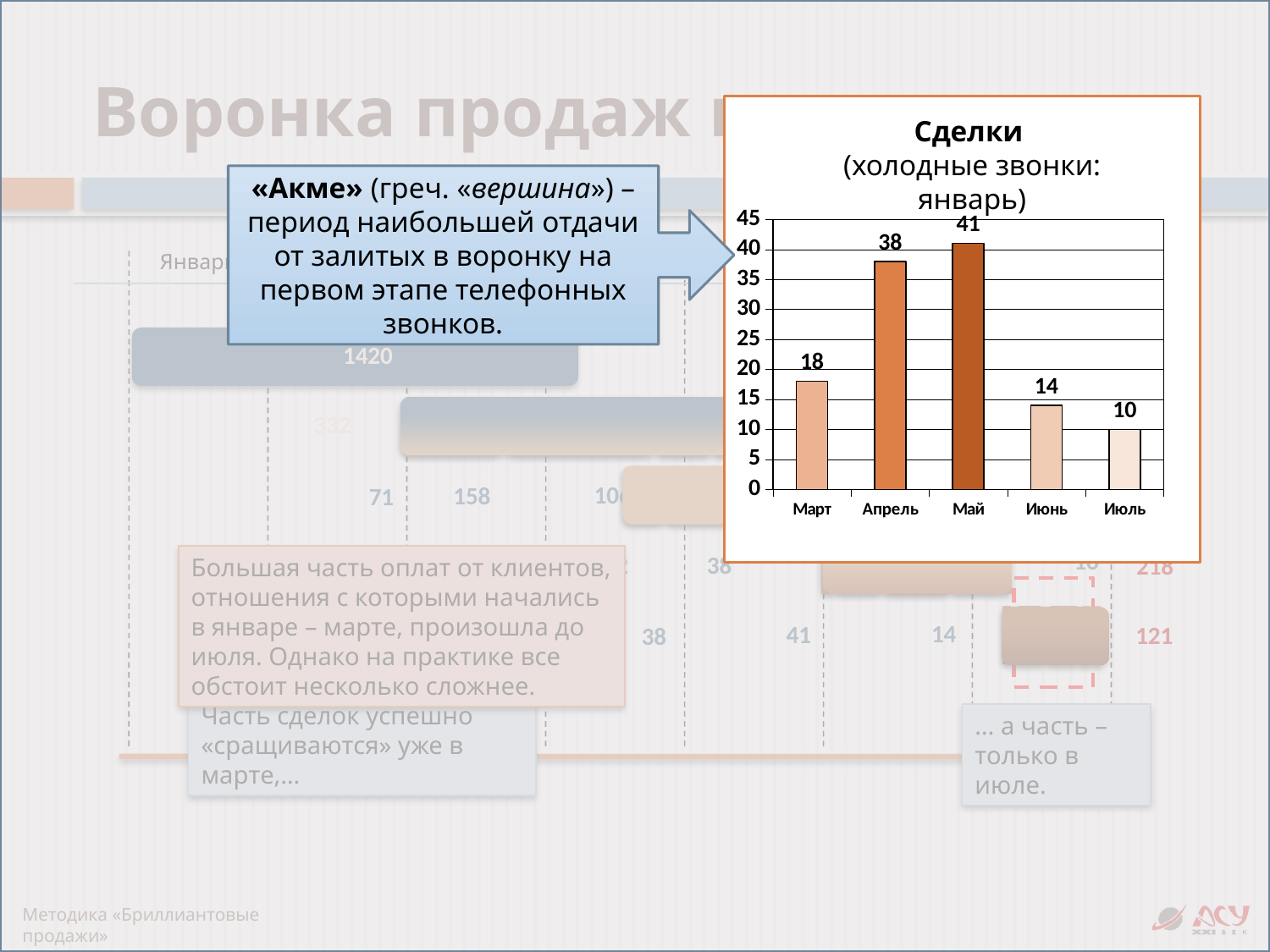
What is the value for Май in the chart? 41 Which month has the highest value in the chart? Май What is the difference between the values for Апрель and Июнь? 24 Which is larger, the value for Март or the value for Июнь? Март How many months are shown on the x axis of the chart? 5 What is the title of the chart? Сделки (холодные звонки: январь) What is the value for Июль in the chart? 10 Is the value for Апрель greater or less than 35? greater Which month has the lowest value in the chart? Июль Do the values rise or fall from Май to Июль? fall What kind of chart is shown on the slide? bar chart What is the value for Март in the chart? 18